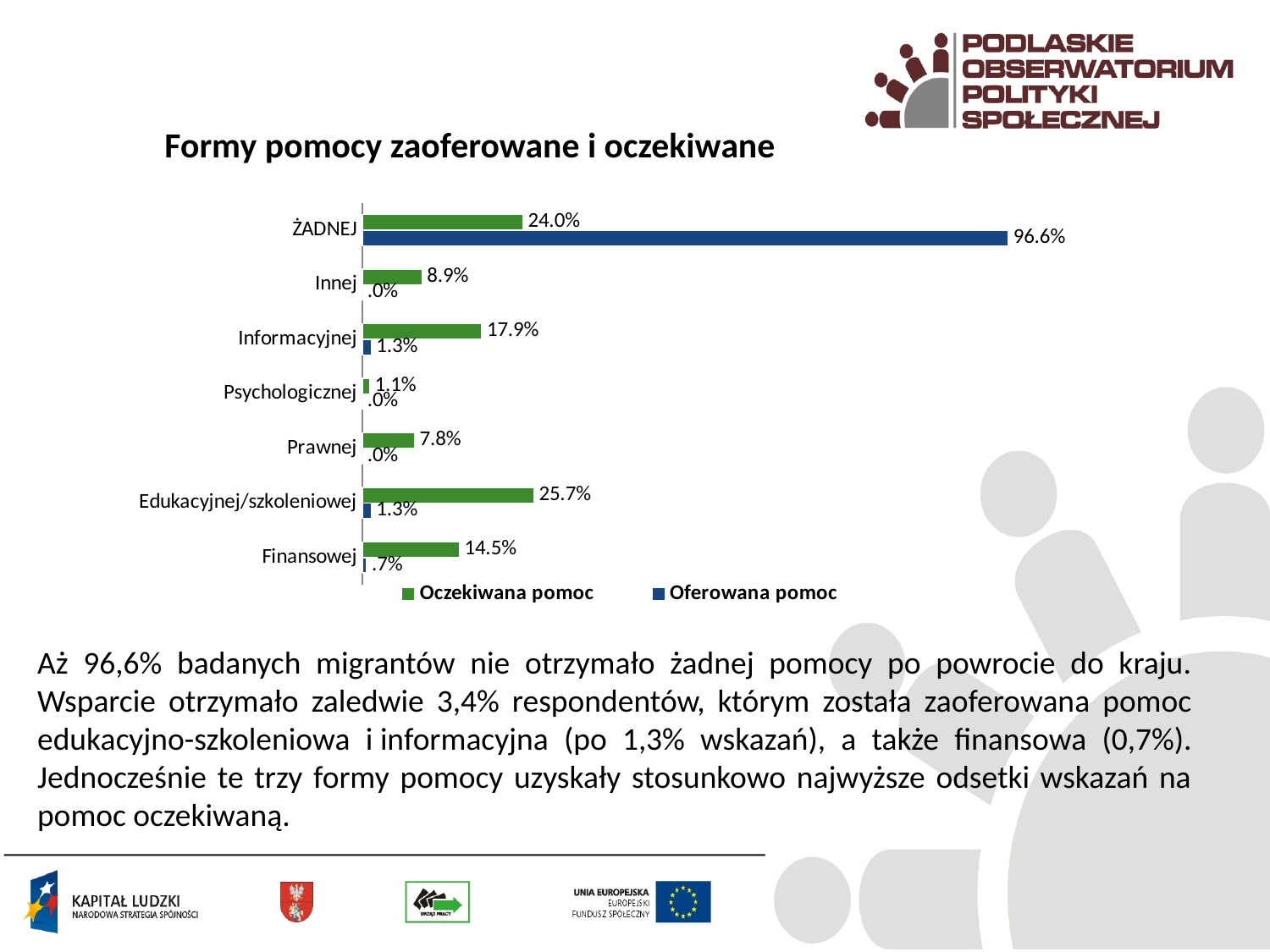
What is the title of the chart? Formy pomocy zaoferowane i oczekiwane What is the value of Oczekiwana pomoc for Informacyjnej? 17.9% What is the value of Oferowana pomoc for ŻADNEJ? 96.6% How many series does the legend list? 2 What is the value of Oczekiwana pomoc for Edukacyjnej/szkoleniowej? 25.7% Which category has the lowest value for Oczekiwana pomoc? Psychologicznej Which is larger for Finansowej: Oczekiwana pomoc or Oferowana pomoc? Oczekiwana pomoc How many categories are shown on the chart? 7 What is the value of Oferowana pomoc for Finansowej? .7% What is the difference between Oczekiwana pomoc and Oferowana pomoc for ŻADNEJ? 72.6% What type of chart is shown on the slide? bar chart Which category has the highest value for Oczekiwana pomoc? Edukacyjnej/szkoleniowej